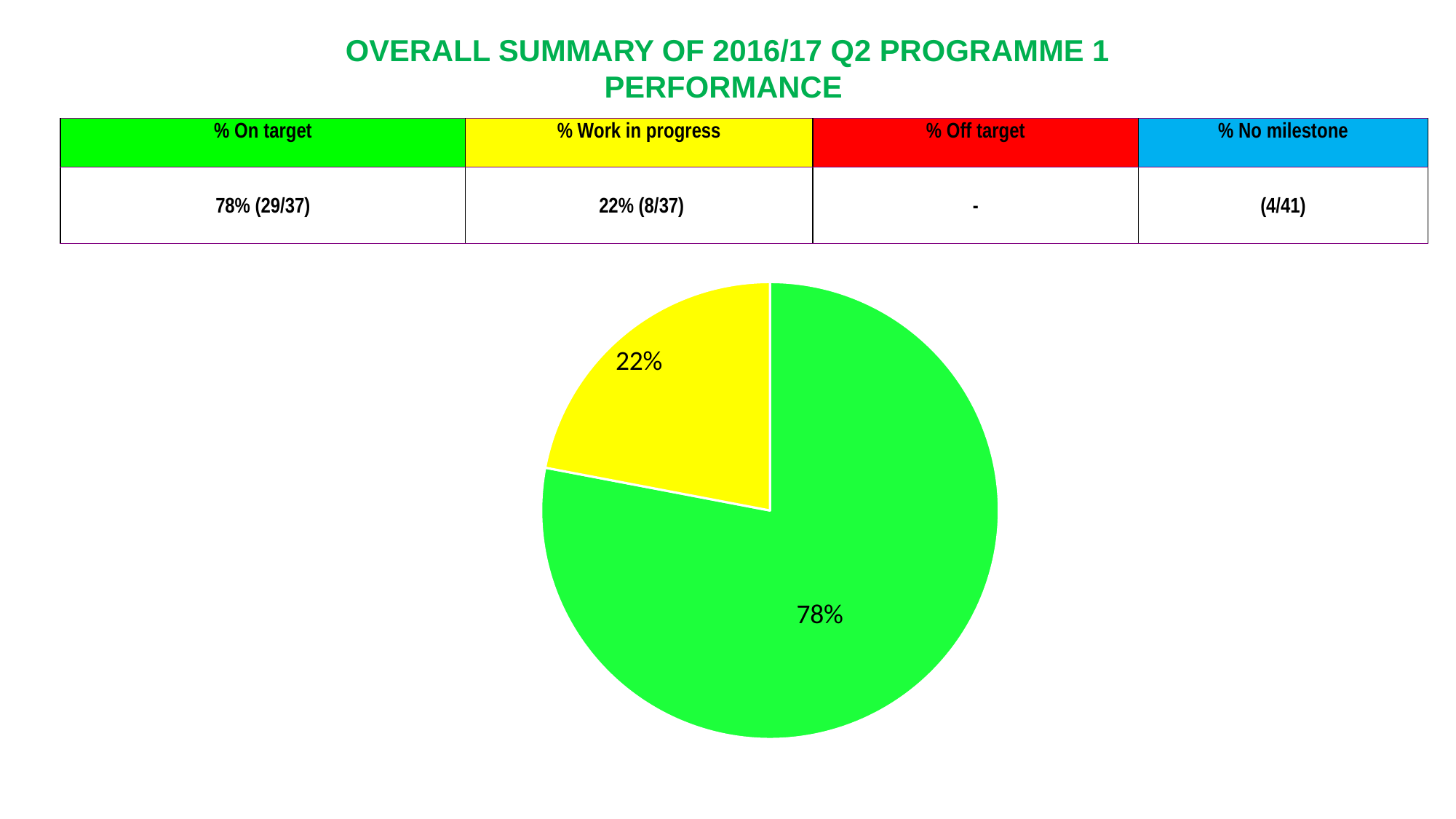
Which slice of the pie chart is the smallest? the yellow slice (22%) How many slices does the pie chart have? 2 Is the green slice larger or smaller than the yellow slice? larger According to the table, which status category does the yellow colour represent? % Work in progress According to the table, which status category does the green colour represent? % On target What share of the pie does the green slice represent? 78% What is the difference in percentage points between the green slice and the yellow slice? 56 Which slice of the pie chart is the largest? the green slice (78%) Is the share of the yellow slice greater or less than 50%? less What share of the pie does the yellow slice represent? 22% What kind of chart is shown on the slide? pie chart